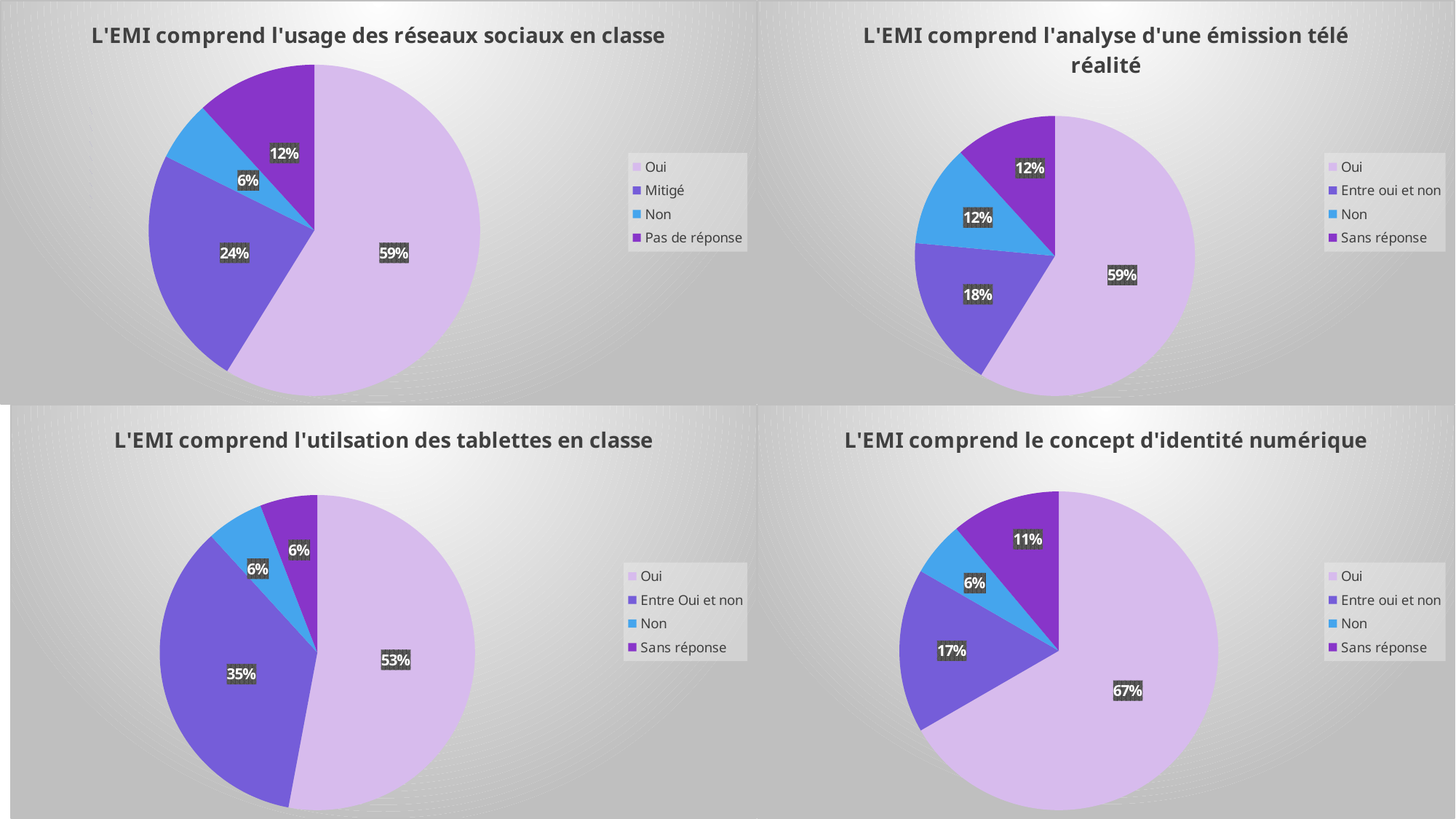
In the chart titled "L'EMI comprend l'analyse d'une émission télé réalité", how many categories does the legend list? 4 In the chart titled "L'EMI comprend l'usage des réseaux sociaux en classe", what is the last entry in the legend? Pas de réponse In the chart titled "L'EMI comprend l'utilsation des tablettes en classe", what is the value for "Entre Oui et non"? 35% In the chart titled "L'EMI comprend l'analyse d'une émission télé réalité", what is the difference between "Oui" and "Entre oui et non"? 41% In the chart titled "L'EMI comprend l'analyse d'une émission télé réalité", what is the value for "Entre oui et non"? 18% What kind of chart is used in the top-left chart on the slide? Pie chart In the chart titled "L'EMI comprend l'usage des réseaux sociaux en classe", what share does "Oui" have? 59% In the chart titled "L'EMI comprend le concept d'identité numérique", which is larger, "Entre oui et non" or "Sans réponse"? Entre oui et non In the chart titled "L'EMI comprend le concept d'identité numérique", what share does "Oui" have? 67% In the chart titled "L'EMI comprend l'usage des réseaux sociaux en classe", which category has the smallest slice? Non In the chart titled "L'EMI comprend l'usage des réseaux sociaux en classe", what is the value for "Mitigé"? 24% In the chart titled "L'EMI comprend l'utilsation des tablettes en classe", which category has the largest slice? Oui